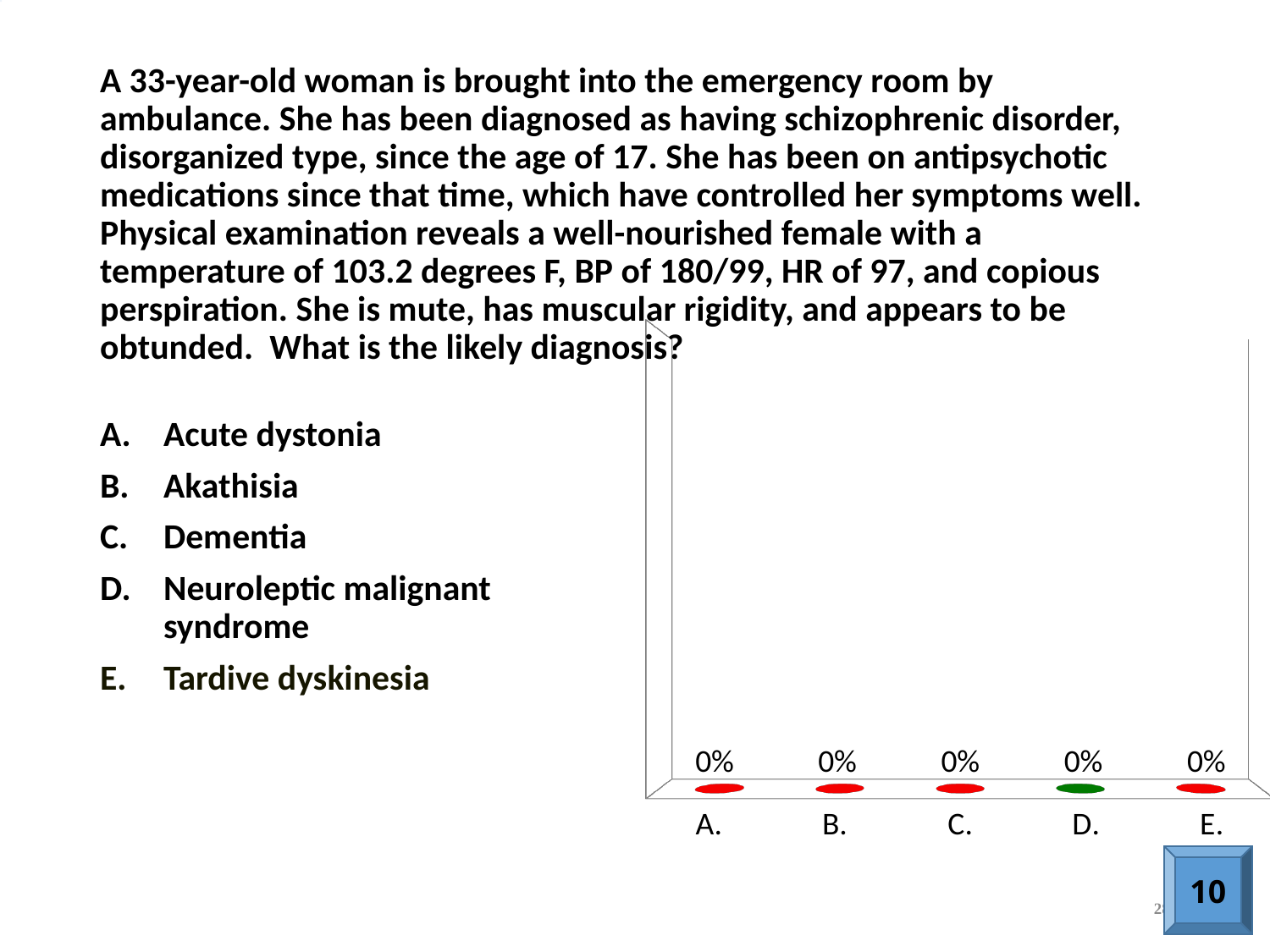
What value is shown for category C. in the chart? 0% What value is shown for category A. in the chart? 0% What kind of chart is shown on the slide? bar chart How many categories are plotted along the x axis of the chart? 5 What is the difference between the values for category A. and category D.? 0% What value is shown for category B. in the chart? 0% What value is shown for category D. in the chart? 0% Which category's bar is coloured green rather than red? D. What are the category labels along the x axis of the chart? A., B., C., D., E. What value is shown for category E. in the chart? 0%